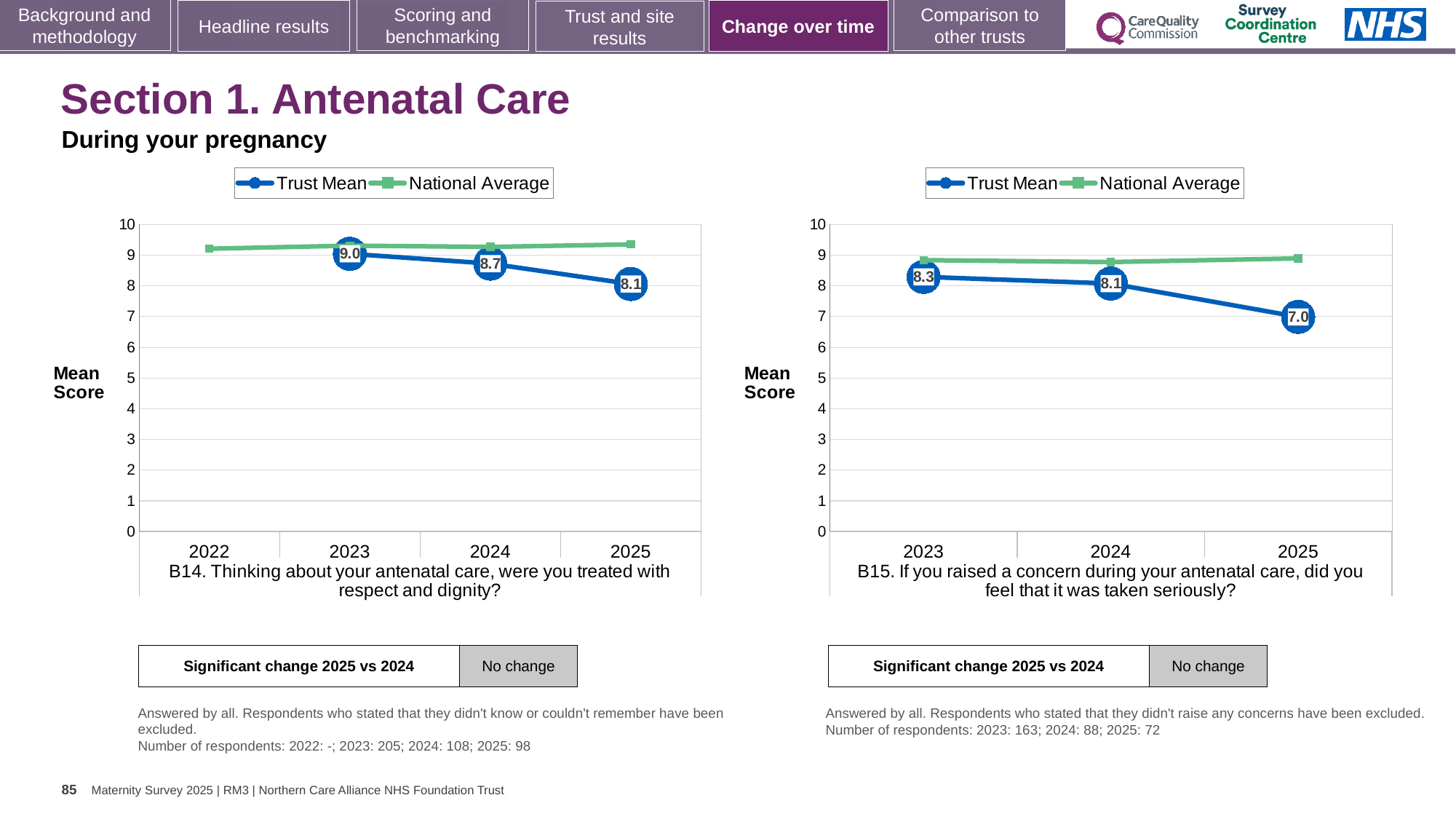
In the B14 chart (left), what is the Trust Mean score for 2023? 9.0 In the B15 chart (right), what is the Trust Mean score for 2023? 8.3 How many series does the legend of the B15 chart (right) list? 2 In the B14 chart (left), what is the Trust Mean score for 2025? 8.1 In the B15 chart (right), which year has the lowest Trust Mean score? 2025 What kind of chart is the B14 chart (left)? Line chart In the B14 chart (left), is the National Average for 2025 greater or less than 9? greater In the B15 chart (right), what is the difference between the Trust Mean in 2024 and 2025? 1.1 In the B14 chart (left), which year has the highest Trust Mean score? 2023 In the B15 chart (right), what is the Trust Mean score for 2025? 7.0 In the B14 chart (left), by how much did the Trust Mean fall from 2023 to 2025? 0.9 In the B15 chart (right), is the Trust Mean for 2025 higher or lower than the National Average for 2025? lower